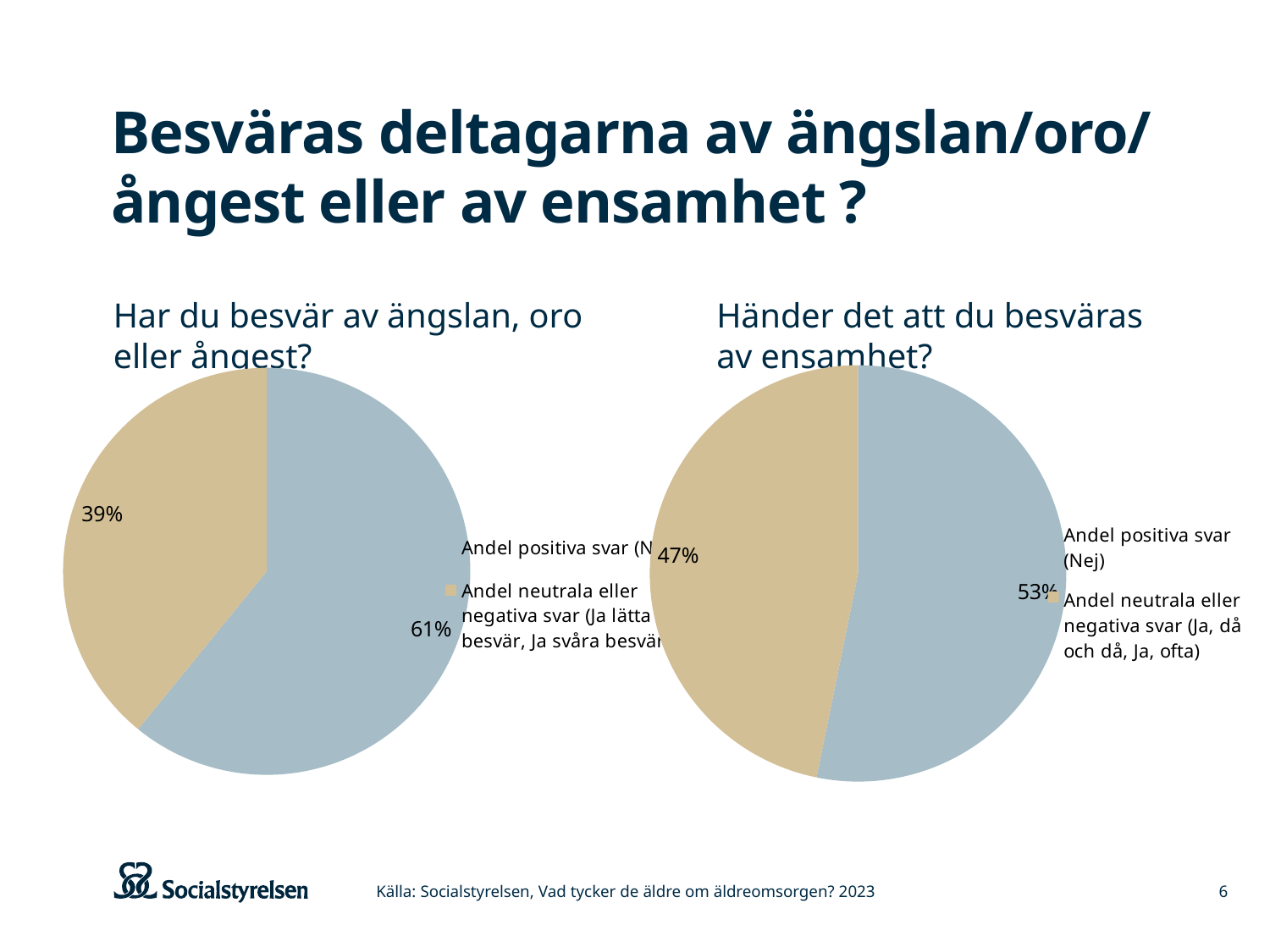
How many charts are shown on the slide? 2 What type of chart is used on this slide? Pie chart What is the title of the right pie chart? Händer det att du besväras av ensamhet? In the right pie chart 'Händer det att du besväras av ensamhet?', what share is labelled for the larger slice? 53% How many slices does the left pie chart 'Har du besvär av ängslan, oro eller ångest?' have? 2 In the left pie chart 'Har du besvär av ängslan, oro eller ångest?', what is the difference between the two slices? 22 percentage points In the right pie chart 'Händer det att du besväras av ensamhet?', what is the difference between the two slices? 6 percentage points In the right pie chart 'Händer det att du besväras av ensamhet?', what is the first legend entry? Andel positiva svar (Nej) In the left pie chart 'Har du besvär av ängslan, oro eller ångest?', what share is labelled for the smaller slice? 39% Which is larger: the 61% slice in the left pie chart or the 53% slice in the right pie chart? The 61% slice in the left pie chart In the right pie chart 'Händer det att du besväras av ensamhet?', what share is labelled for the smaller slice? 47% In the left pie chart 'Har du besvär av ängslan, oro eller ångest?', what share is labelled for the larger slice? 61%